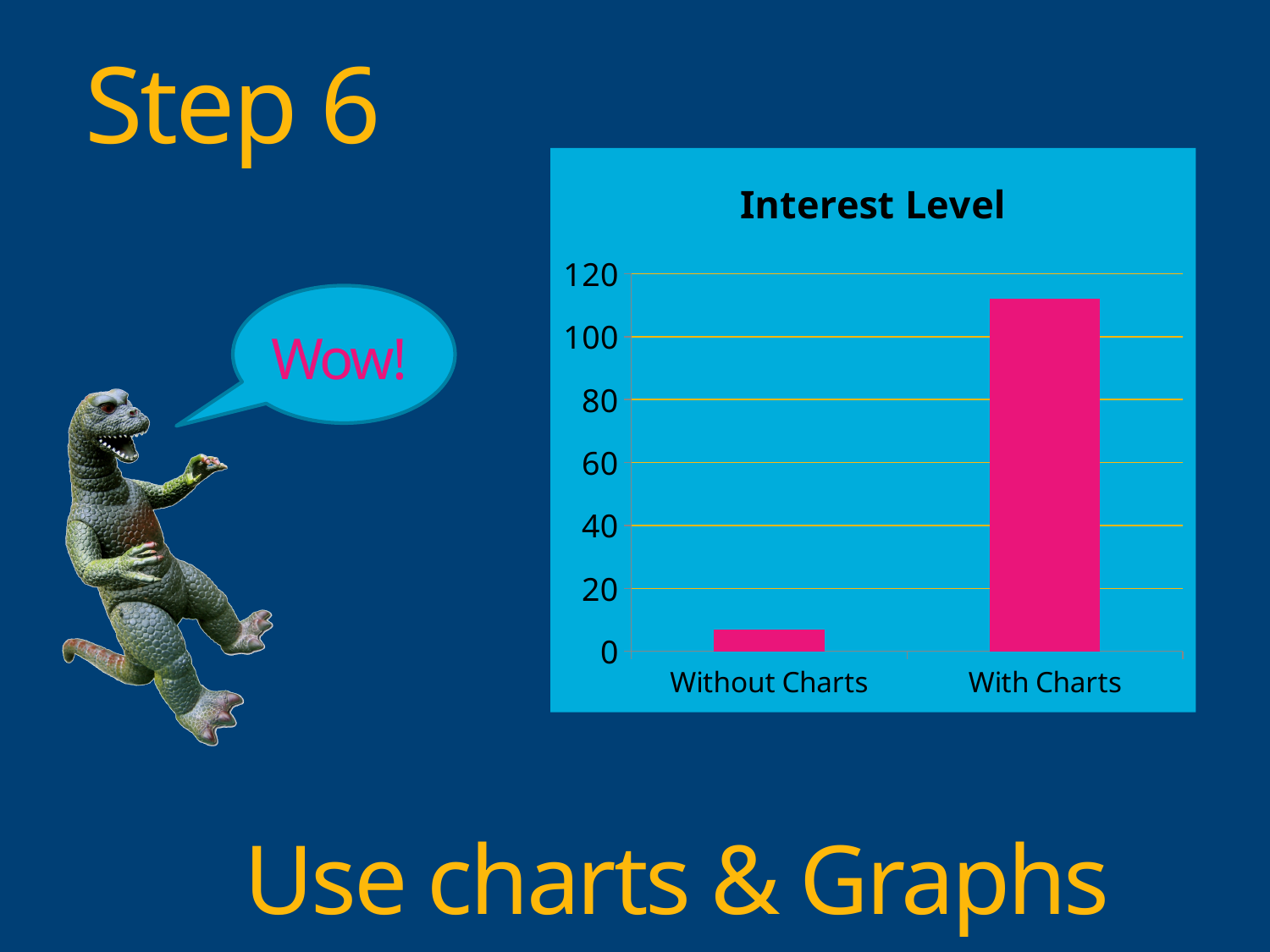
Is the value for Without Charts greater or less than 20? less Which category has the highest value in the chart? With Charts What is the highest value shown on the y axis of the chart? 120 Which is larger, the value for Without Charts or the value for With Charts? With Charts Which category has the lowest value in the chart? Without Charts What is the title of the chart? Interest Level Do the values rise or fall from Without Charts to With Charts? rise What kind of chart is shown on the slide? bar chart Is the value for With Charts greater or less than 120? less Is the value for With Charts greater or less than 100? greater How many categories are shown on the x axis of the chart? 2